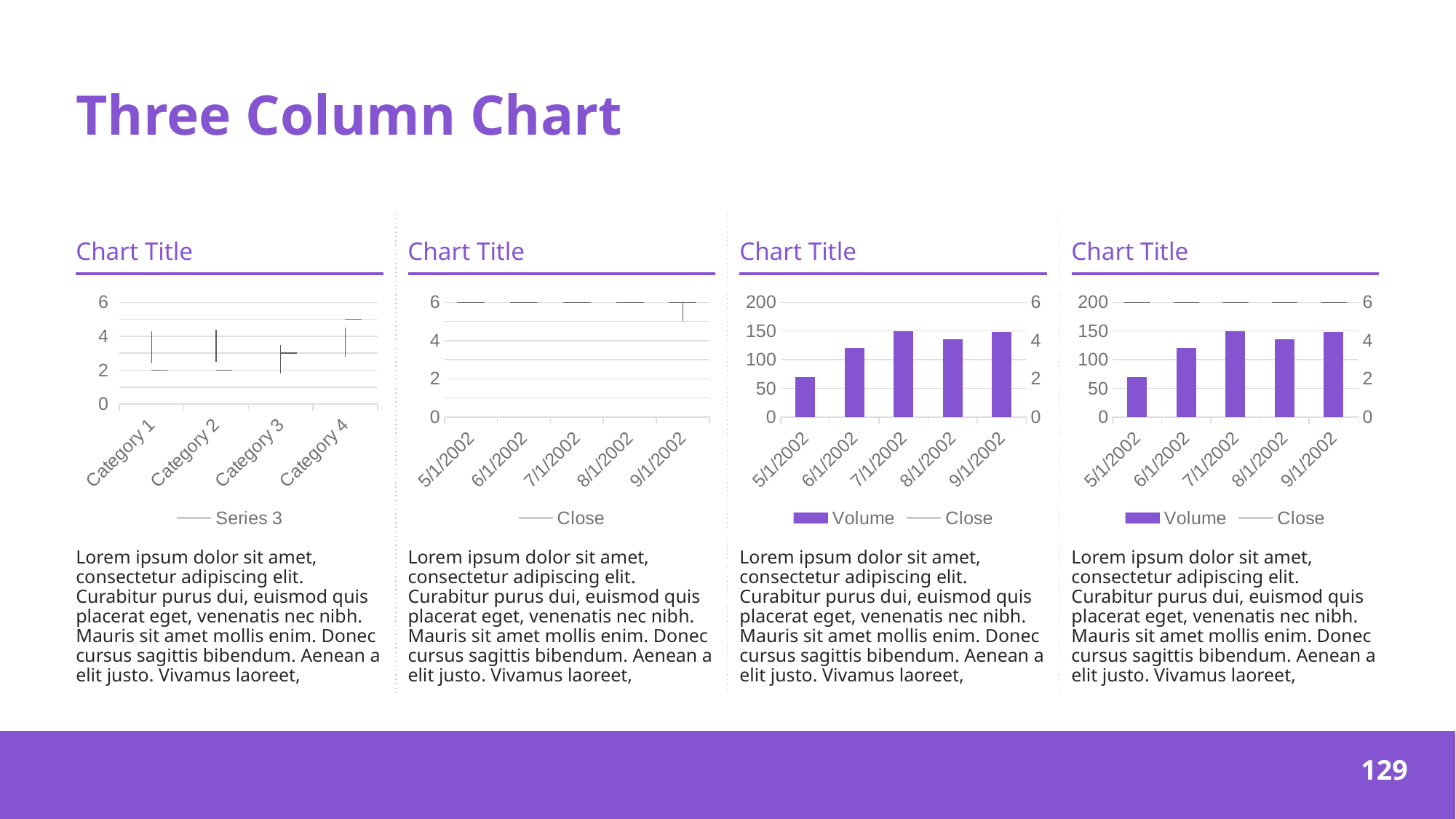
In the third chart from the left, which has the larger Volume bar, 5/1/2002 or 6/1/2002? 6/1/2002 In the rightmost chart, is the Volume value for 6/1/2002 greater or less than 150? less How many dates are shown on the x axis of the second chart from the left? 5 What are the two legend entries of the rightmost chart? Volume and Close In the rightmost chart, is the Volume value for 5/1/2002 greater or less than 100? less How many series does the legend of the third chart from the left list? 2 How many series does the legend of the second chart from the left list? 1 What is the maximum value shown on the left vertical axis of the third chart from the left? 200 How many categories are shown on the x axis of the leftmost chart? 4 In the rightmost chart, is the Volume value for 7/1/2002 greater or less than 100? greater In the third chart from the left, which date has the lowest Volume bar? 5/1/2002 What series name does the legend of the leftmost chart show? Series 3